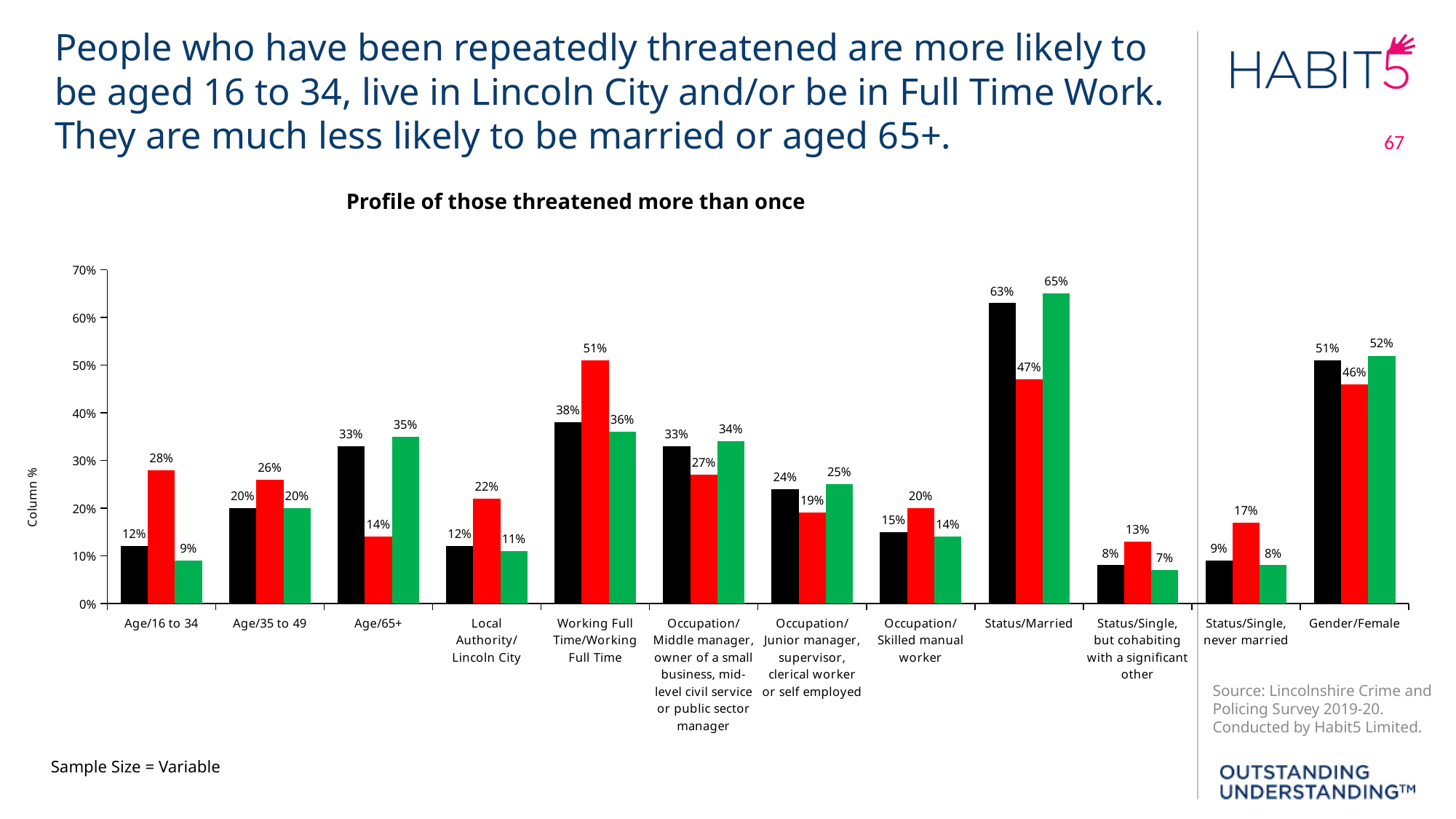
What is the difference between the red bar and the black bar for Working Full Time/Working Full Time? 13% Which is larger for Age/65+: the black bar or the red bar? the black bar What is the title of the chart? Profile of those threatened more than once Which category has the lowest red bar? Status/Single, but cohabiting with a significant other What is the value of the black bar for Status/Married? 63% What type of chart is shown? bar chart How many bars are shown for each category? 3 What is the value of the green bar for Working Full Time/Working Full Time? 36% What is the value of the red bar for Age/16 to 34? 28% How many categories are shown on the x axis? 12 Is the value of the red bar for Status/Married greater or less than 50%? less Which category has the highest green bar? Status/Married